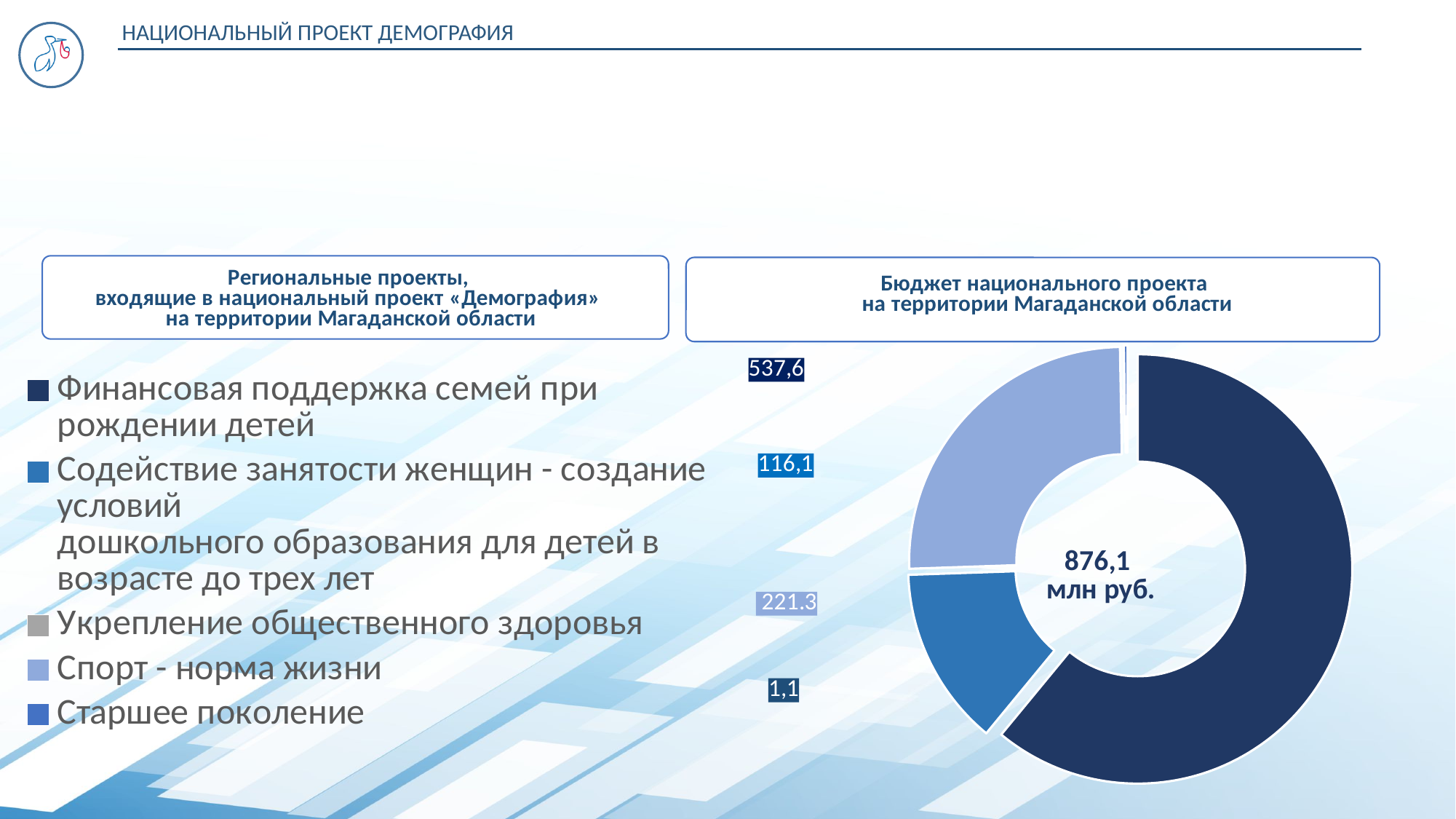
What is the difference between the values 537,6 and 221.3 on the donut chart? 316.3 What is the difference between the "Спорт - норма жизни" slice (221.3) and the "Содействие занятости женщин" slice (116,1)? 105.2 What total value is printed in the centre of the donut chart? 876,1 млн руб. Which slice is larger: "Спорт - норма жизни" or "Содействие занятости женщин"? Спорт - норма жизни What kind of chart is shown under "Бюджет национального проекта на территории Магаданской области"? Donut (pie) chart What is the value of the medium blue slice, "Содействие занятости женщин - создание условий дошкольного образования для детей в возрасте до трех лет"? 116,1 How many regional projects are listed in the legend of the chart? 5 What is the smallest data label shown on the donut chart? 1,1 What is the value of the light blue slice, "Спорт - норма жизни"? 221.3 Which regional project has the largest slice of the budget donut chart? Финансовая поддержка семей при рождении детей What is the value of the dark navy slice, "Финансовая поддержка семей при рождении детей"? 537,6 What colour is the legend marker for "Укрепление общественного здоровья"? Gray